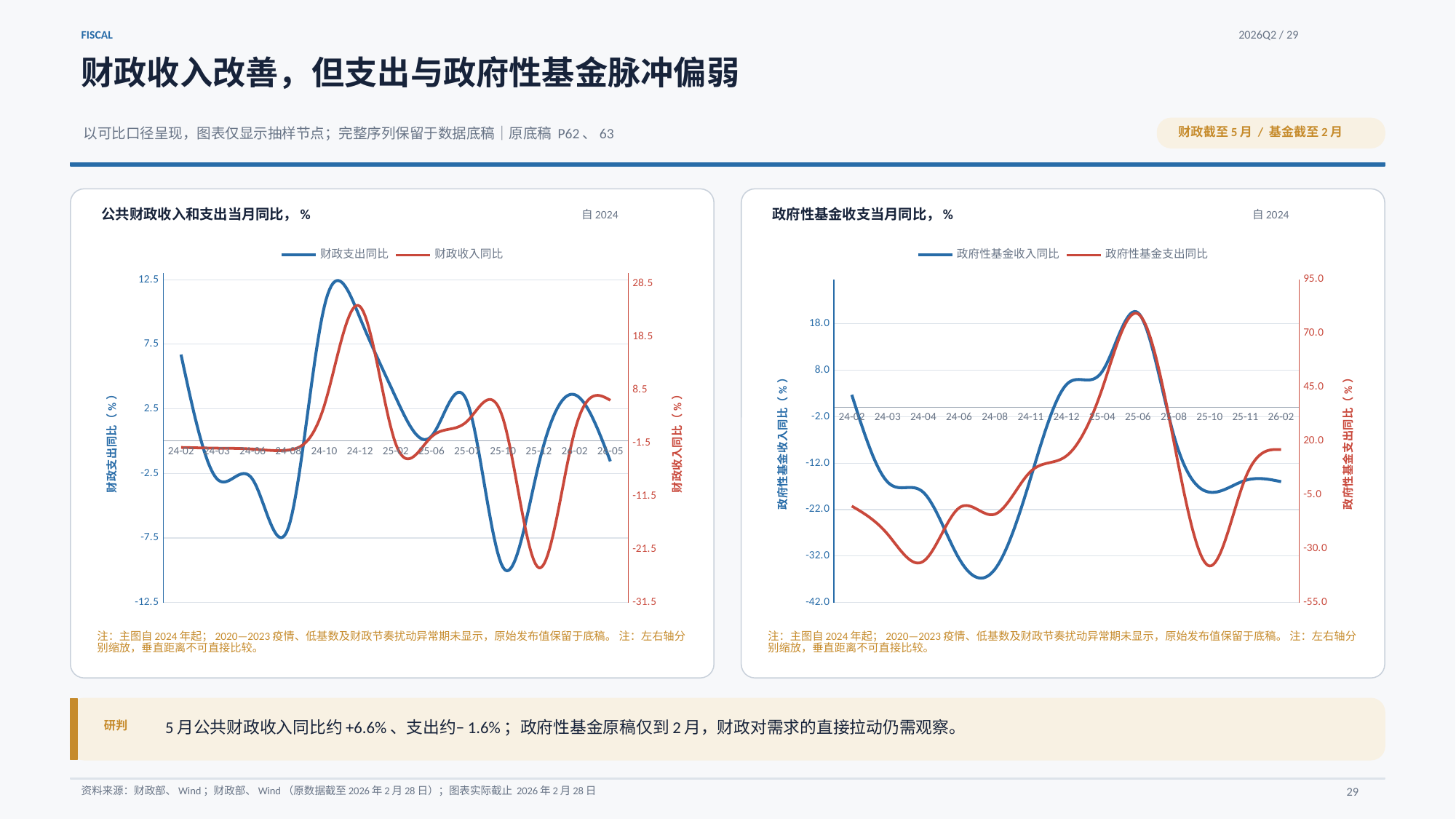
In the right chart (政府性基金收支当月同比), at which x-axis point is 政府性基金收入同比 lowest? 24-08 In the left chart (公共财政收入和支出当月同比), at which x-axis point is 财政支出同比 lowest? 25-10 In the left chart (公共财政收入和支出当月同比), is the value of 财政收入同比 at 24-12 greater or less than 18.5? greater In the left chart (公共财政收入和支出当月同比), at which x-axis point is 财政支出同比 highest? 24-10 What kind of chart is the left chart titled 公共财政收入和支出当月同比，%? line chart In the left chart (公共财政收入和支出当月同比), how many series does the legend list? 2 In the right chart (政府性基金收支当月同比), what are the two legend entries? 政府性基金收入同比, 政府性基金支出同比 In the left chart (公共财政收入和支出当月同比), is the value of 财政支出同比 at 25-10 greater or less than -7.5? less In the right chart (政府性基金收支当月同比), is the value of 政府性基金收入同比 at 24-08 greater or less than -32.0? less In the left chart (公共财政收入和支出当月同比), how many time points are shown on the x axis? 13 In the right chart (政府性基金收支当月同比), at which x-axis point is 政府性基金收入同比 highest? 25-06